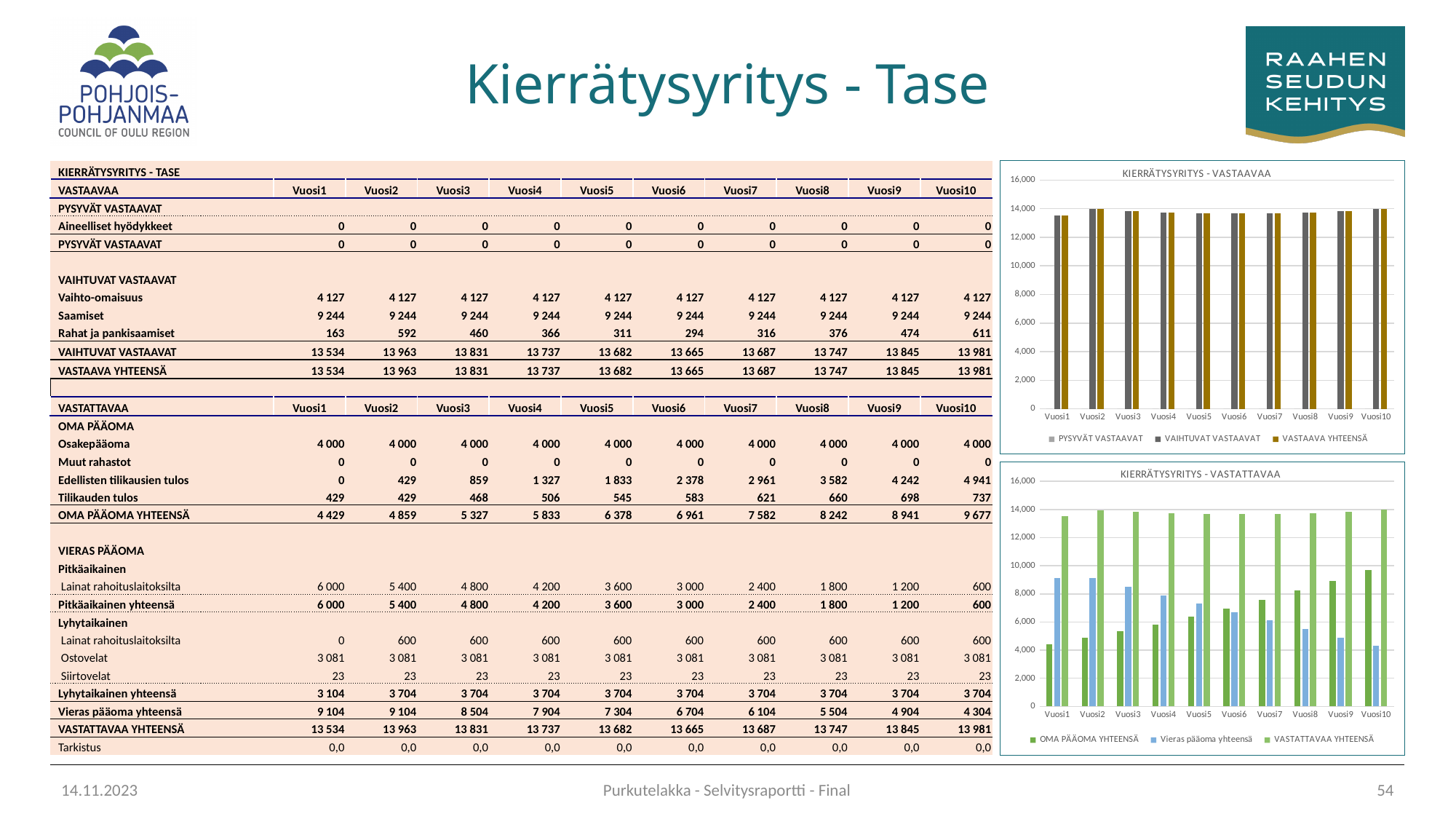
In the KIERRÄTYSYRITYS - VASTATTAVAA chart, do the values for Vieras pääoma yhteensä rise or fall from Vuosi2 to Vuosi10? fall How many series does the legend of the KIERRÄTYSYRITYS - VASTAAVAA chart list? 3 In the KIERRÄTYSYRITYS - VASTATTAVAA chart, which year has the lowest value for Vieras pääoma yhteensä? Vuosi10 In the KIERRÄTYSYRITYS - VASTATTAVAA chart, is the value for OMA PÄÄOMA YHTEENSÄ in Vuosi1 greater or less than 6,000? less In the KIERRÄTYSYRITYS - VASTATTAVAA chart, is the value for Vieras pääoma yhteensä in Vuosi1 greater or less than 8,000? greater In the KIERRÄTYSYRITYS - VASTATTAVAA chart, which year has the highest value for OMA PÄÄOMA YHTEENSÄ? Vuosi10 In the KIERRÄTYSYRITYS - VASTAAVAA chart, is the value for VAIHTUVAT VASTAAVAT in Vuosi1 greater or less than 12,000? greater In the KIERRÄTYSYRITYS - VASTATTAVAA chart, which is larger in Vuosi4: OMA PÄÄOMA YHTEENSÄ or Vieras pääoma yhteensä? Vieras pääoma yhteensä What kind of chart is the KIERRÄTYSYRITYS - VASTAAVAA chart? bar chart What is the title of the chart at the top right of the slide? KIERRÄTYSYRITYS - VASTAAVAA In the KIERRÄTYSYRITYS - VASTATTAVAA chart, do the values for OMA PÄÄOMA YHTEENSÄ rise or fall from Vuosi1 to Vuosi10? rise How many year categories are shown on the x axis of the KIERRÄTYSYRITYS - VASTATTAVAA chart? 10